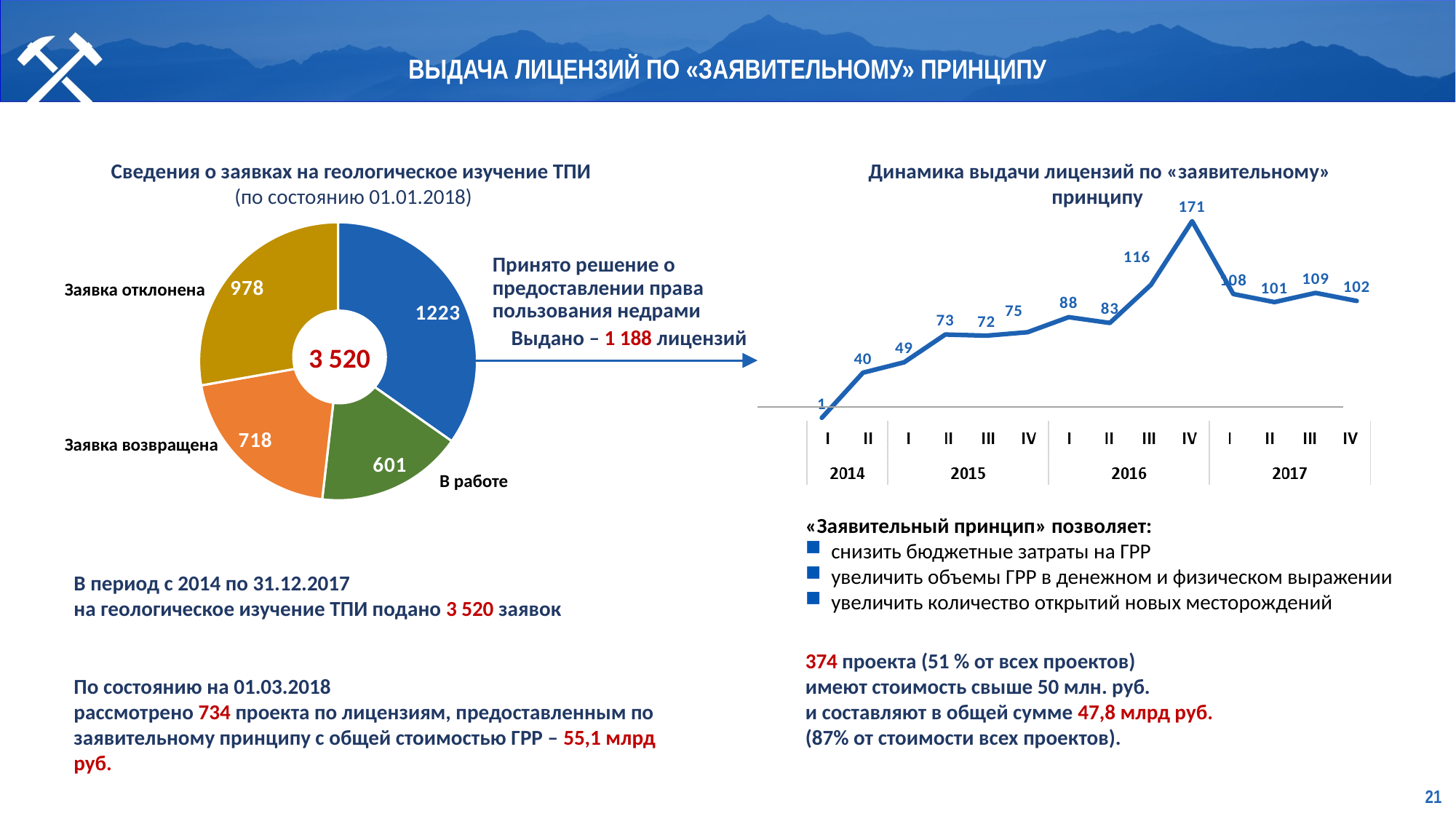
What kind of chart is the left chart titled «Сведения о заявках на геологическое изучение ТПИ»? Pie (donut) chart In the right line chart, what is the value for quarter IV of 2016? 171 In the left pie chart, what is the difference between «Заявка отклонена» and «Заявка возвращена»? 260 In the right line chart, what is the difference between quarter IV of 2016 and quarter I of 2017? 63 In the left pie chart, what is the value for «В работе»? 601 In the right line chart, which quarter has the highest value? IV 2016 What kind of chart is the right chart titled «Динамика выдачи лицензий по «заявительному» принципу»? Line chart In the right line chart, what is the value for quarter I of 2014? 1 In the left pie chart, what is the value for «Заявка отклонена»? 978 In the right line chart, how many data points are plotted? 14 In the left pie chart, which is larger: «Заявка возвращена» or «В работе»? Заявка возвращена In the left pie chart, what total is shown in the centre of the donut? 3 520